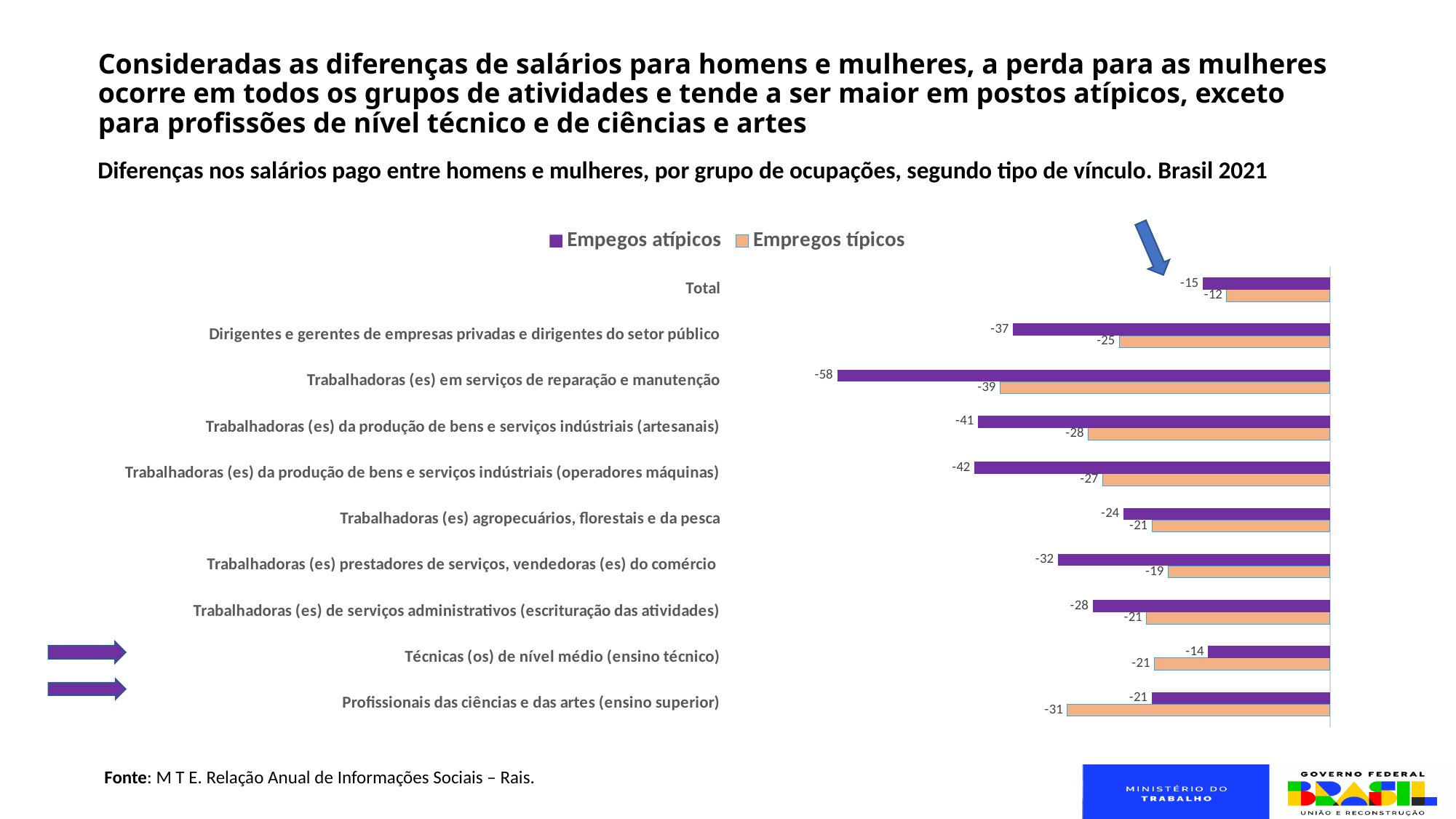
Which category has the highest (least negative) value for Empregos típicos? Total What is the value for Empregos típicos for Profissionais das ciências e das artes (ensino superior)? -31 How many occupation categories (including Total) are plotted on the chart? 10 For Profissionais das ciências e das artes (ensino superior), which series has the more negative value, Empegos atípicos or Empregos típicos? Empregos típicos What is the value for Empegos atípicos in the Total category? -15 What is the difference between the Empegos atípicos and Empregos típicos values for Dirigentes e gerentes de empresas privadas e dirigentes do setor público? 12 What is the value for Empregos típicos for Trabalhadoras (es) em serviços de reparação e manutenção? -39 What type of chart is shown on the slide? Bar chart How many series does the legend list? 2 What is the value for Empegos atípicos for Técnicas (os) de nível médio (ensino técnico)? -14 Which colour represents the Empregos típicos series in the chart? Orange Which category has the lowest (most negative) value for Empegos atípicos? Trabalhadoras (es) em serviços de reparação e manutenção